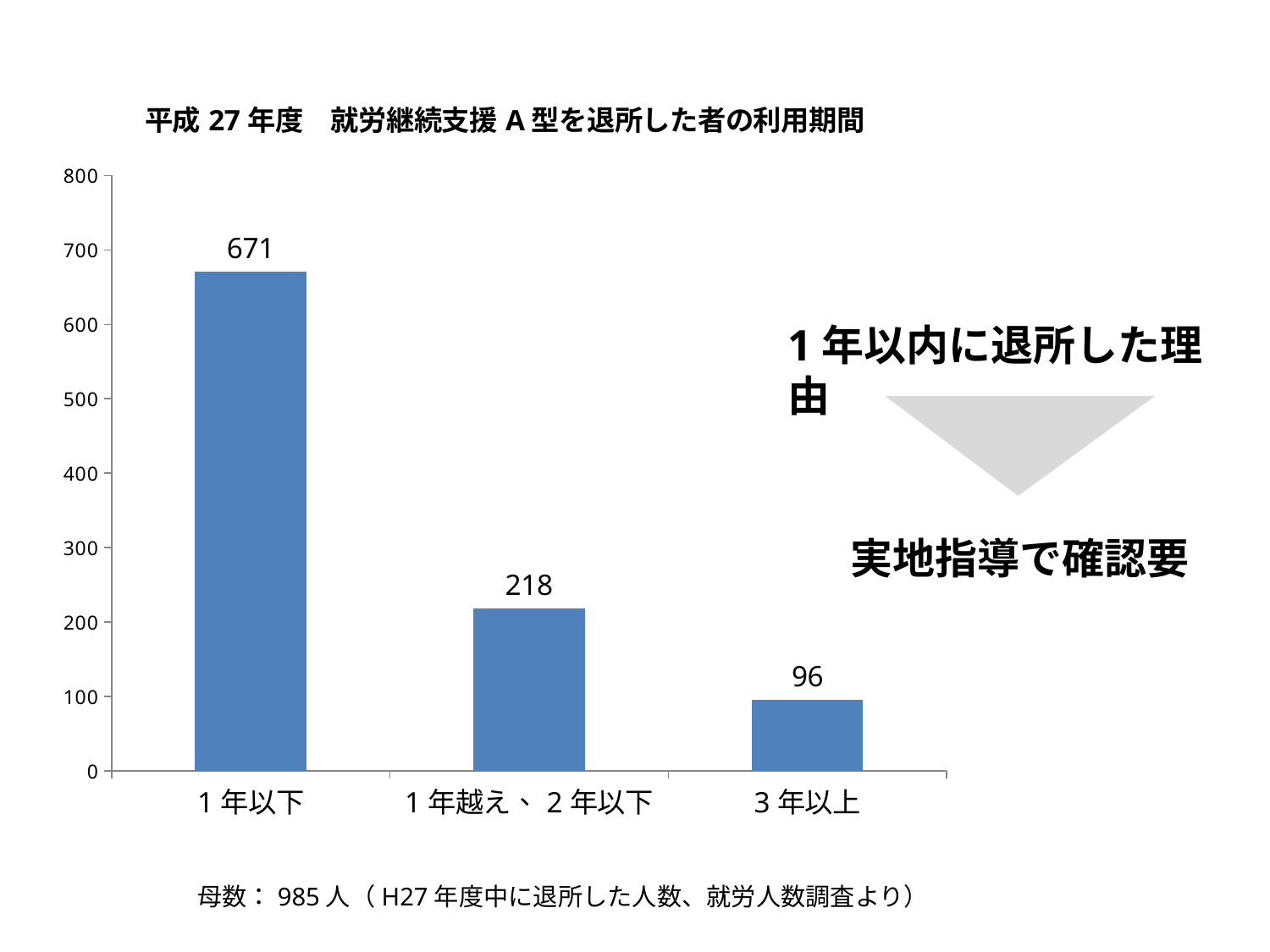
Do the values rise or fall from left to right along the x axis? fall What is the difference between the values for １年越え、２年以下 and ３年以上? 122 What is the difference between the values for １年以下 and １年越え、２年以下? 453 Which category has the lowest value? ３年以上 Is the value for １年以下 greater or less than 600? greater Which category has the highest value? １年以下 What is the value for ３年以上? 96 What is the value for １年以下? 671 What is the value for １年越え、２年以下? 218 Which is larger, the value for １年越え、２年以下 or the value for ３年以上? １年越え、２年以下 How many categories are shown on the x axis? 3 What kind of chart is shown on the slide? bar chart